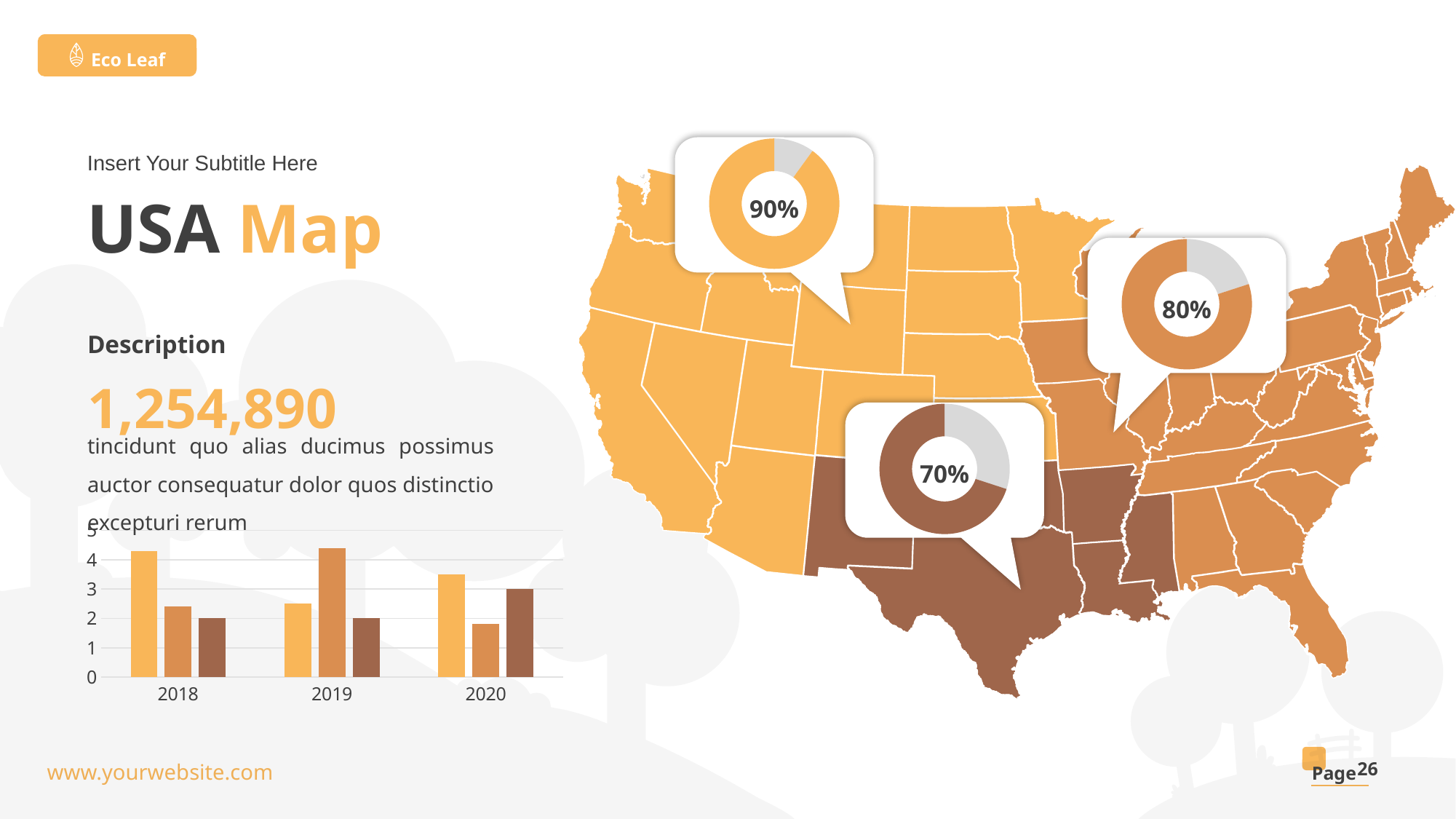
What kind of chart is shown at the bottom left of the slide? bar chart In the bar chart at the bottom left, is the value of the first (light orange) bar for 2018 greater or less than 4? greater In the bar chart at the bottom left, how many year categories are shown on the x axis? 3 In the bar chart at the bottom left, which year has the tallest first (light orange) bar? 2018 Of the three donut charts on the USA map, which shows the lowest percentage? 70% In the bar chart at the bottom left, is the value of the second (medium orange) bar for 2020 greater or less than 2? less In the bar chart at the bottom left, for 2019, which bar is taller: the first (light orange) or the second (medium orange)? the second (medium orange) In the bar chart at the bottom left, is the value of the second (medium orange) bar for 2019 greater or less than 4? greater What percentage is shown in the donut chart over the southern part of the USA map? 70% In the bar chart at the bottom left, how many bars are shown for each year? 3 What percentage is shown in the donut chart over the western part of the USA map? 90% In the bar chart at the bottom left, which year has the tallest third (dark brown) bar? 2020